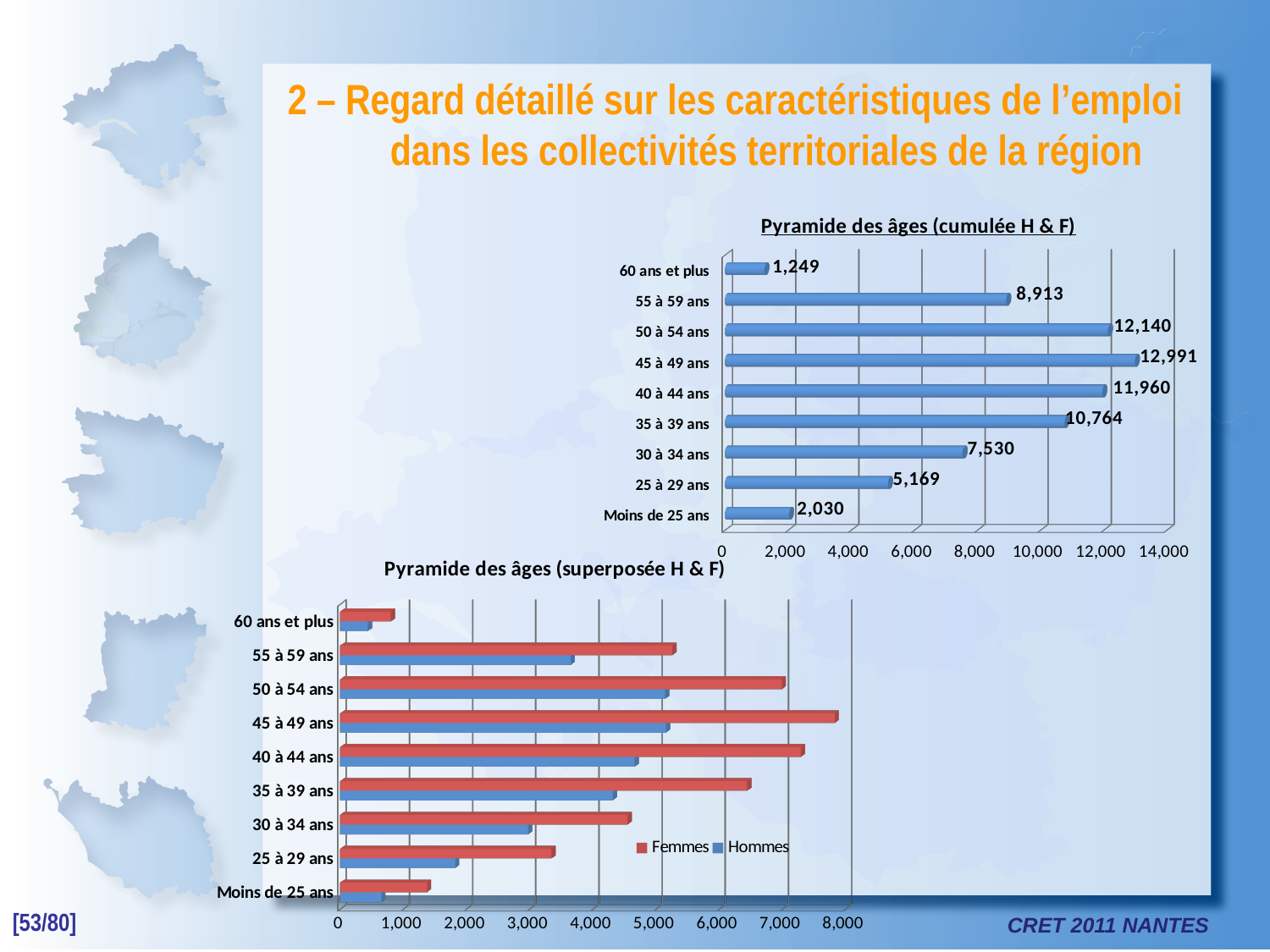
How many series does the legend of the chart 'Pyramide des âges (superposée H & F)' list? 2 In the chart 'Pyramide des âges (superposée H & F)', is the value for Hommes in '60 ans et plus' greater or less than 1,000? less In the chart 'Pyramide des âges (cumulée H & F)', which is larger: the value for '35 à 39 ans' or for '30 à 34 ans'? 35 à 39 ans In the chart 'Pyramide des âges (cumulée H & F)', what is the value for 'Moins de 25 ans'? 2,030 How many age groups are shown in the chart 'Pyramide des âges (cumulée H & F)'? 9 In the chart 'Pyramide des âges (cumulée H & F)', what is the value for '45 à 49 ans'? 12,991 In the chart 'Pyramide des âges (cumulée H & F)', which age group has the highest value? 45 à 49 ans In the chart 'Pyramide des âges (superposée H & F)', is the value for Femmes in '45 à 49 ans' greater or less than 7,000? greater In the chart 'Pyramide des âges (superposée H & F)', which series is shown in red? Femmes What kind of chart is 'Pyramide des âges (superposée H & F)'? Bar chart In the chart 'Pyramide des âges (cumulée H & F)', what is the difference between the values for '50 à 54 ans' and '55 à 59 ans'? 3,227 In the chart 'Pyramide des âges (cumulée H & F)', which age group has the lowest value? 60 ans et plus